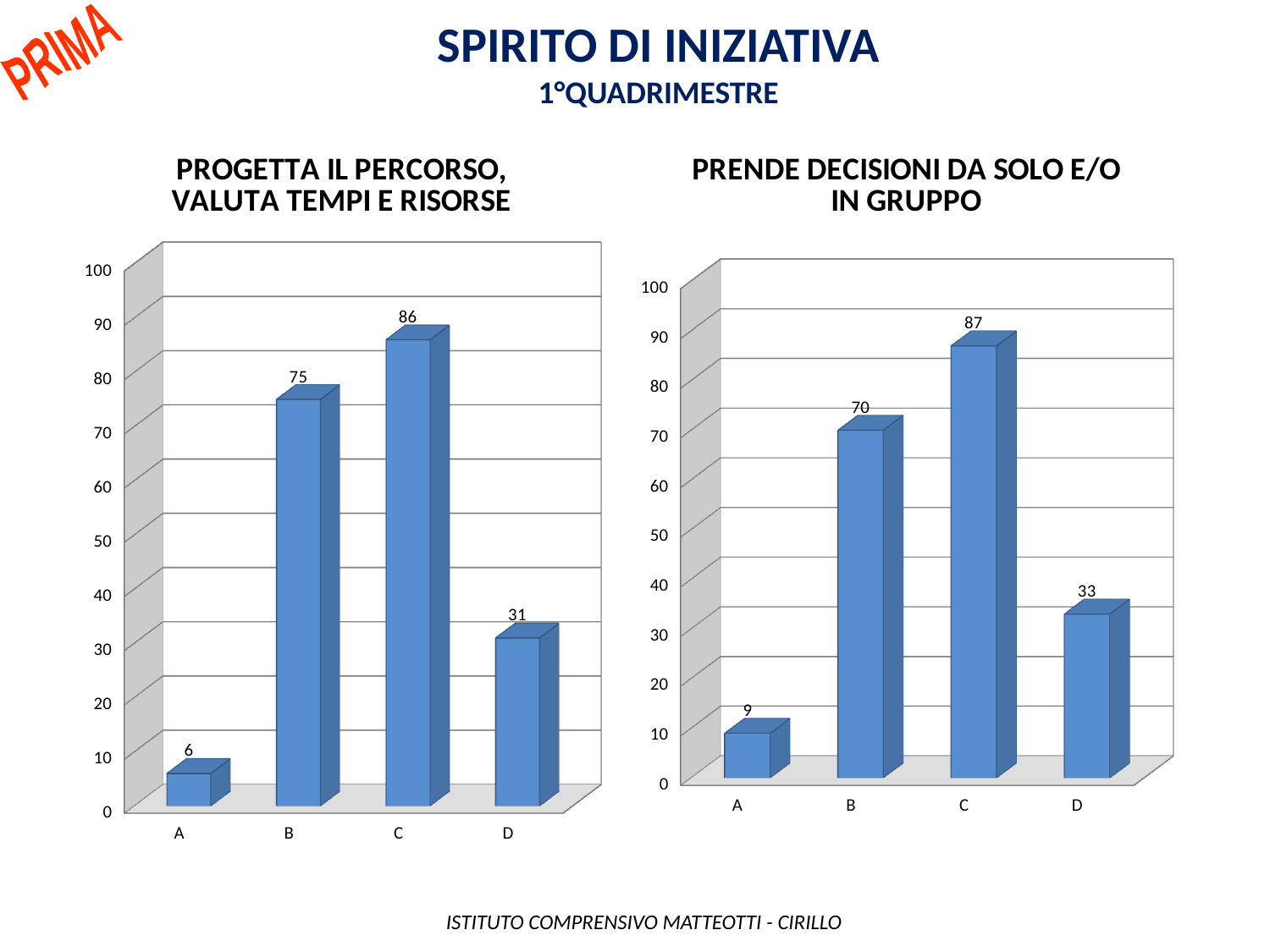
What kind of chart is the one titled 'PROGETTA IL PERCORSO, VALUTA TEMPI E RISORSE'? Bar chart In the right chart ('PRENDE DECISIONI DA SOLO E/O IN GRUPPO'), which category has the highest value? C In the chart titled 'PROGETTA IL PERCORSO, VALUTA TEMPI E RISORSE', what is the value for category B? 75 In the chart titled 'PROGETTA IL PERCORSO, VALUTA TEMPI E RISORSE', what is the value for category C? 86 In the left chart ('PROGETTA IL PERCORSO, VALUTA TEMPI E RISORSE'), is the value for D greater or less than 40? less In the right chart ('PRENDE DECISIONI DA SOLO E/O IN GRUPPO'), which is larger, the value for B or the value for D? B In the chart titled 'PRENDE DECISIONI DA SOLO E/O IN GRUPPO', what is the value for category A? 9 In the left chart ('PROGETTA IL PERCORSO, VALUTA TEMPI E RISORSE'), which category has the lowest value? A How many categories are shown in the chart titled 'PRENDE DECISIONI DA SOLO E/O IN GRUPPO'? 4 In the chart titled 'PROGETTA IL PERCORSO, VALUTA TEMPI E RISORSE', what is the difference between the values for B and D? 44 What is the title of the chart on the right side of the slide? PRENDE DECISIONI DA SOLO E/O IN GRUPPO In the chart titled 'PRENDE DECISIONI DA SOLO E/O IN GRUPPO', what is the difference between the values for C and B? 17